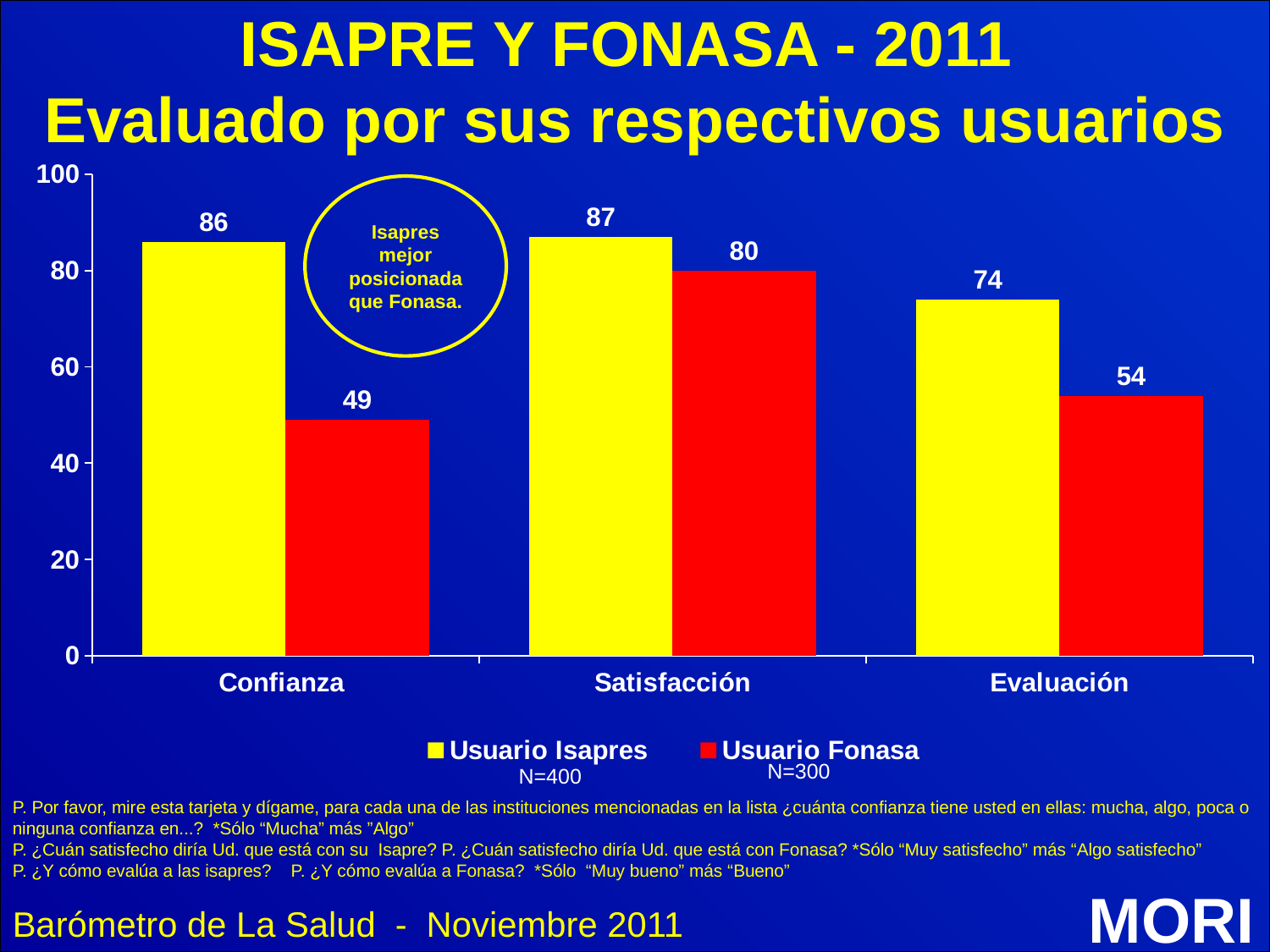
What kind of chart is shown on the slide? Bar chart How many series does the legend list? 2 What is the value for Usuario Isapres in the Evaluación category? 74 What is the value for Usuario Isapres in the Confianza category? 86 In which category does Usuario Isapres have its highest value? Satisfacción How many categories are shown on the x axis? 3 What is the difference between Usuario Isapres and Usuario Fonasa in the Confianza category? 37 Which is larger in the Satisfacción category: Usuario Isapres or Usuario Fonasa? Usuario Isapres What is the value for Usuario Fonasa in the Confianza category? 49 What is the value for Usuario Fonasa in the Satisfacción category? 80 What is the difference between Usuario Isapres and Usuario Fonasa in the Evaluación category? 20 In which category does Usuario Fonasa have its lowest value? Confianza